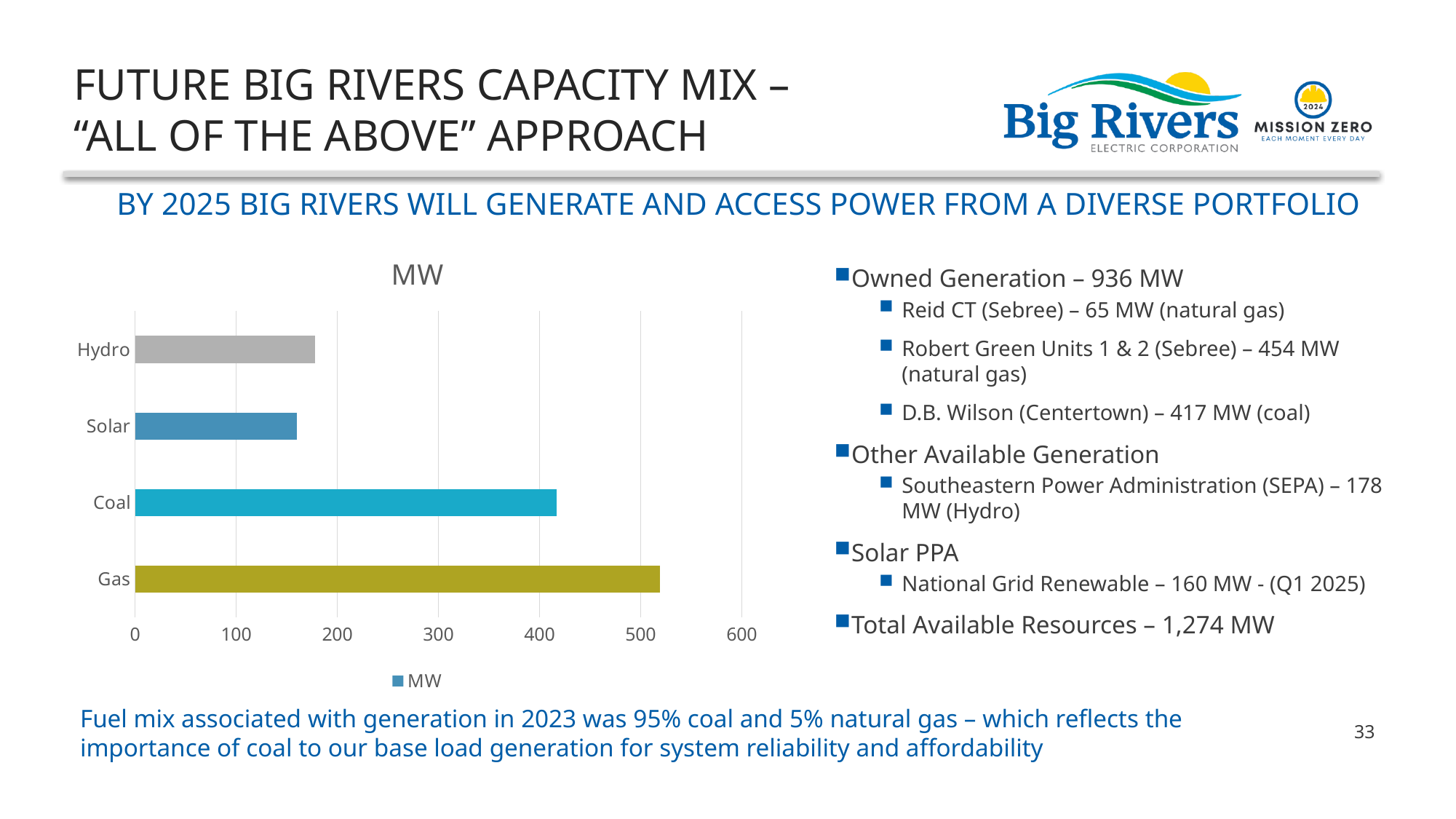
Is the value for Hydro greater or less than 100? greater What is the title of the chart? MW What kind of chart is shown on the slide? bar chart Is the value for Gas greater or less than 500? greater Which category has the highest value in the chart? Gas What is the highest value shown on the chart's horizontal axis? 600 How many series does the chart legend list? 1 How many categories are plotted in the chart? 4 Is the value for Solar greater or less than 200? less Which is larger, the value for Coal or the value for Hydro? Coal Which is larger, the value for Gas or the value for Solar? Gas